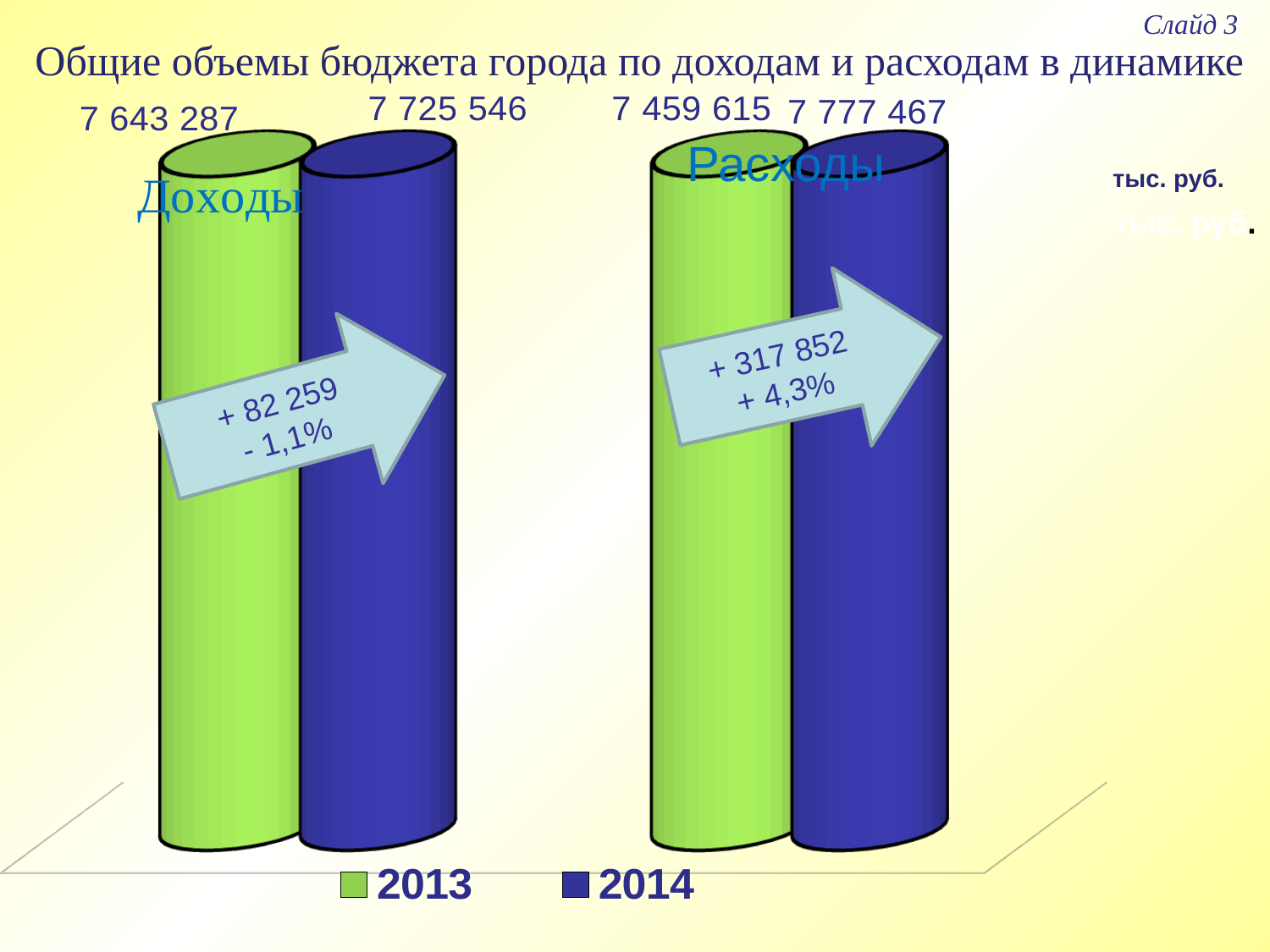
What is the value for Расходы in 2014? 7 777 467 How many series does the legend list? 2 What is the value for Расходы in 2013? 7 459 615 What is the value for Доходы in 2014? 7 725 546 Which bar has the highest value on the chart? Расходы 2014 Which bar has the lowest value on the chart? Расходы 2013 Which is larger in 2013, Доходы or Расходы? Доходы By how much did Доходы increase from 2013 to 2014? 82 259 By how much did Расходы increase from 2013 to 2014? 317 852 Which is larger in 2014, Доходы or Расходы? Расходы What type of chart is shown on the slide? Bar chart What is the value for Доходы in 2013? 7 643 287